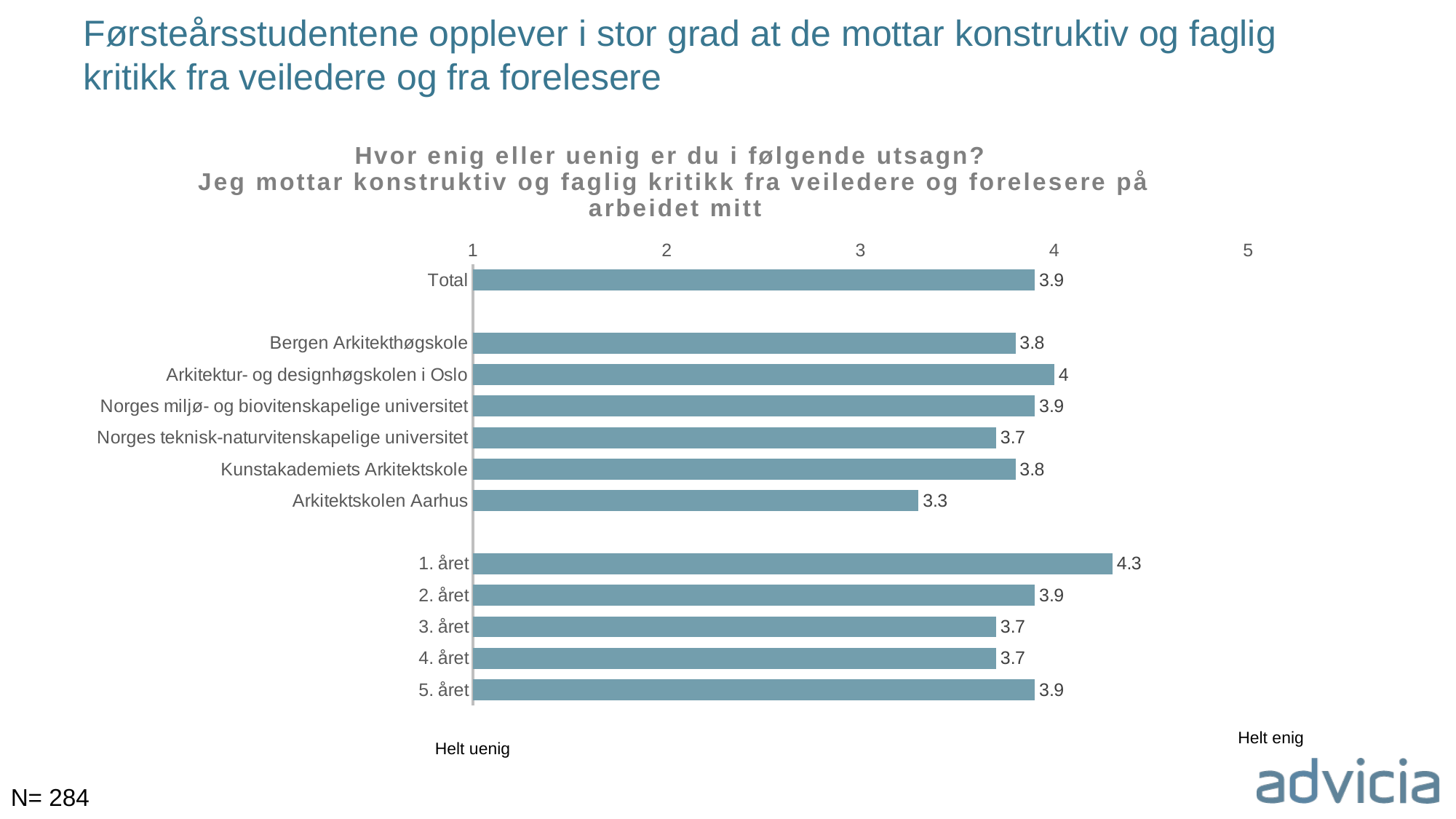
Is the value for Arkitektskolen Aarhus greater or less than 4? less What is the value for Arkitektskolen Aarhus? 3.3 What label appears at the right end of the scale? Helt enig What kind of chart is shown on the slide? bar chart What is the value for 1. året? 4.3 What is the difference between the values for 1. året and Arkitektskolen Aarhus? 1 What is the value for Arkitektur- og designhøgskolen i Oslo? 4 Which is larger, the value for Bergen Arkitekthøgskole or the value for Norges teknisk-naturvitenskapelige universitet? Bergen Arkitekthøgskole How many bars are plotted in the chart? 12 What is the value for Total? 3.9 Which category has the highest value? 1. året Which category has the lowest value? Arkitektskolen Aarhus